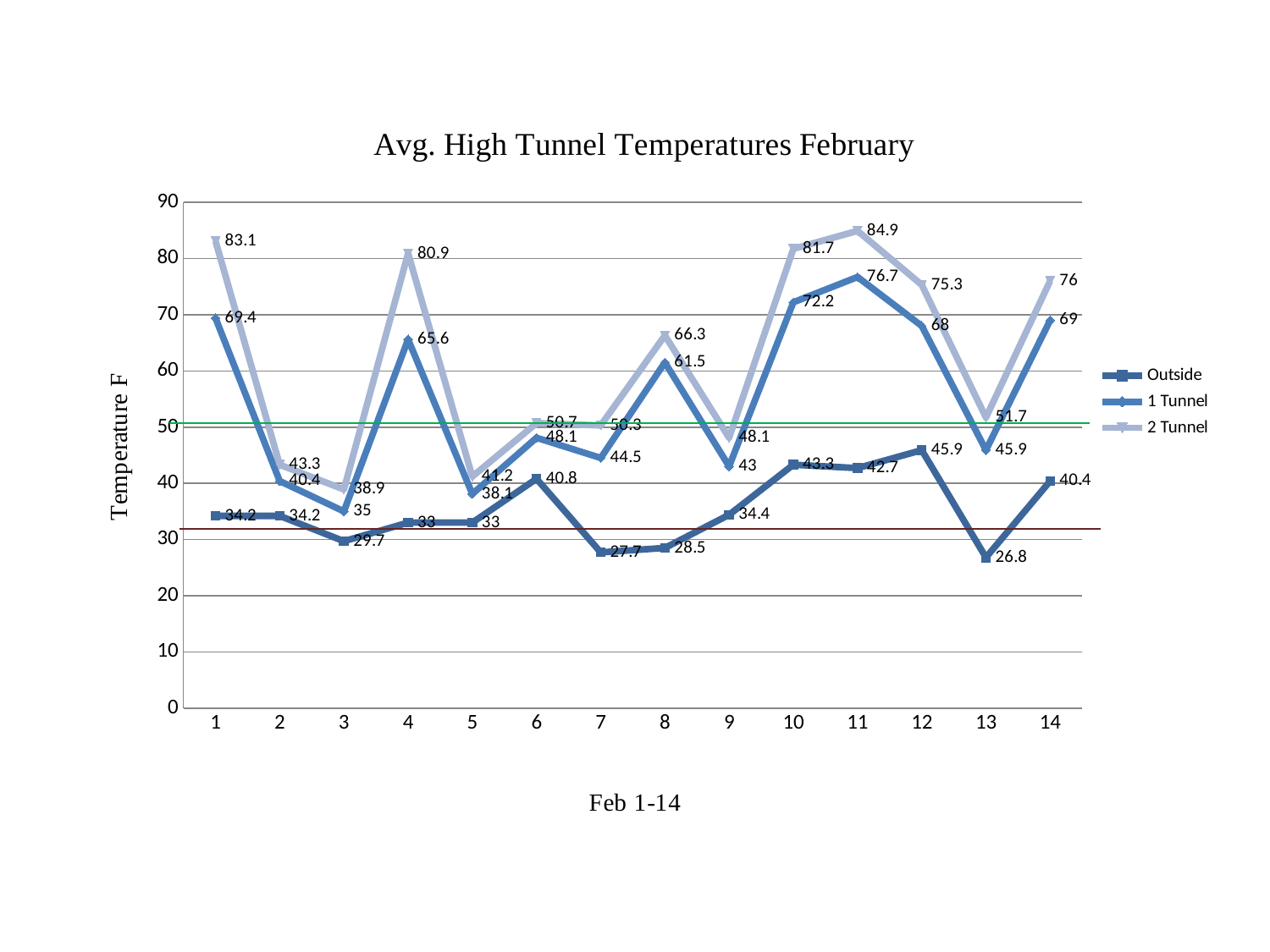
What is the difference between the 2 Tunnel and Outside temperatures on day 1? 48.9 What is the 2 Tunnel temperature on day 11? 84.9 What is the 1 Tunnel temperature on day 4? 65.6 What is the title of the chart? Avg. High Tunnel Temperatures February How many series does the legend list? 3 How many days are plotted along the x axis? 14 What is the Outside temperature on day 13? 26.8 On which day does the Outside series reach its lowest value? 13 On which day does the 2 Tunnel series reach its highest value? 11 Which is higher on day 8, the 1 Tunnel value or the Outside value? 1 Tunnel What type of chart is shown on the slide? line chart Is the 1 Tunnel value on day 10 greater or less than 70? greater